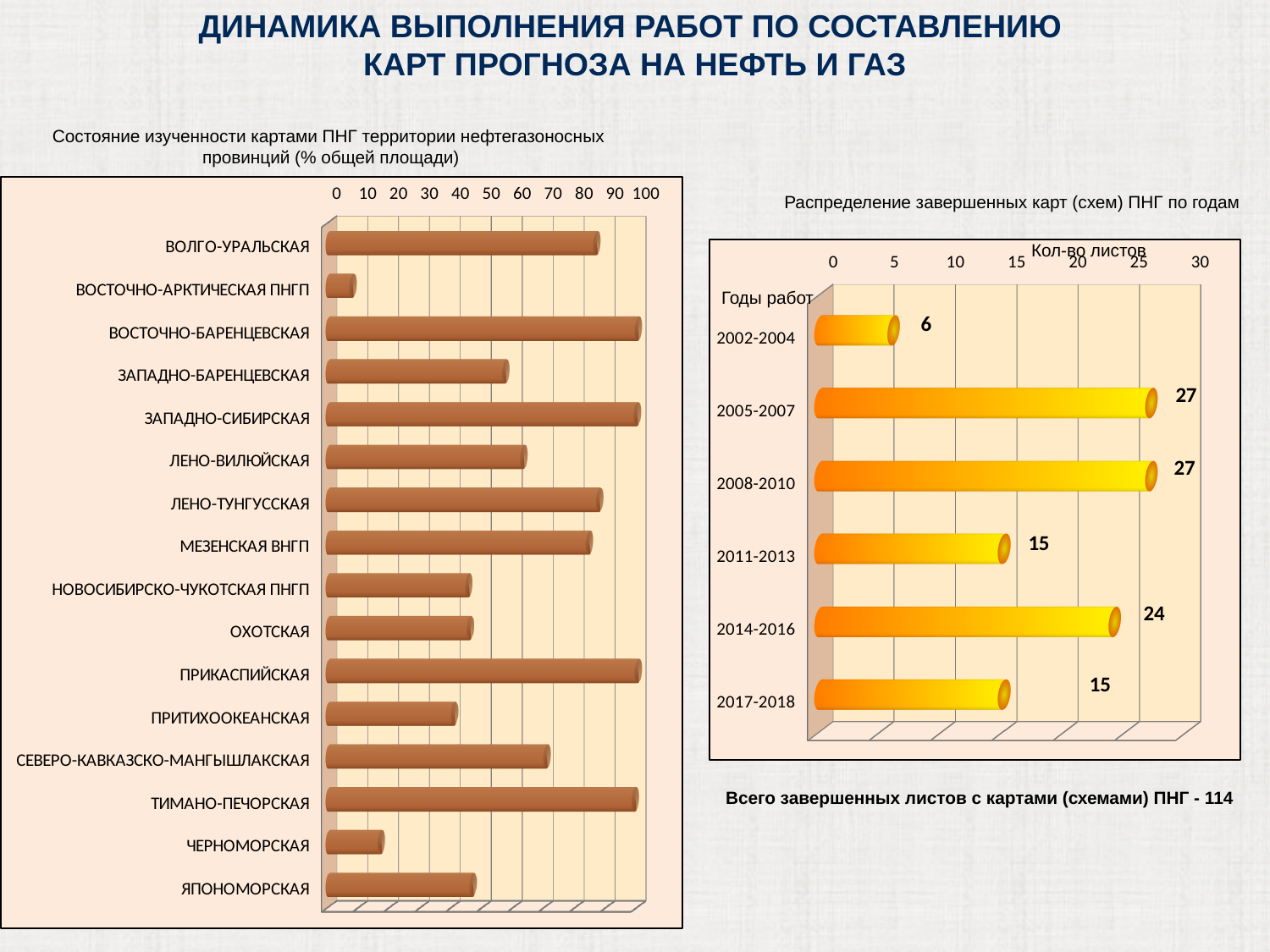
In the chart on the left, is the value for ЧЕРНОМОРСКАЯ greater or less than 30? less In the chart on the right, what is the value for 2014-2016? 24 In the chart on the right, which is larger: the value for 2005-2007 or the value for 2017-2018? 2005-2007 In the chart on the right, how many periods (categories) are shown? 6 In the chart on the left, how many provinces are listed? 16 In the chart on the right, which period has the lowest number of sheets? 2002-2004 In the chart on the right, what is the difference between the values for 2014-2016 and 2011-2013? 9 In the chart on the left, is the value for ВОЛГО-УРАЛЬСКАЯ greater or less than 80? greater In the chart on the right (Распределение завершенных карт (схем) ПНГ по годам), how many sheets were completed in 2002-2004? 6 In the chart on the left, is the value for ПРИТИХООКЕАНСКАЯ greater or less than 50? less What kind of chart is the chart on the left? bar chart In the chart on the left (Состояние изученности картами ПНГ), which province has the lowest value? ВОСТОЧНО-АРКТИЧЕСКАЯ ПНГП